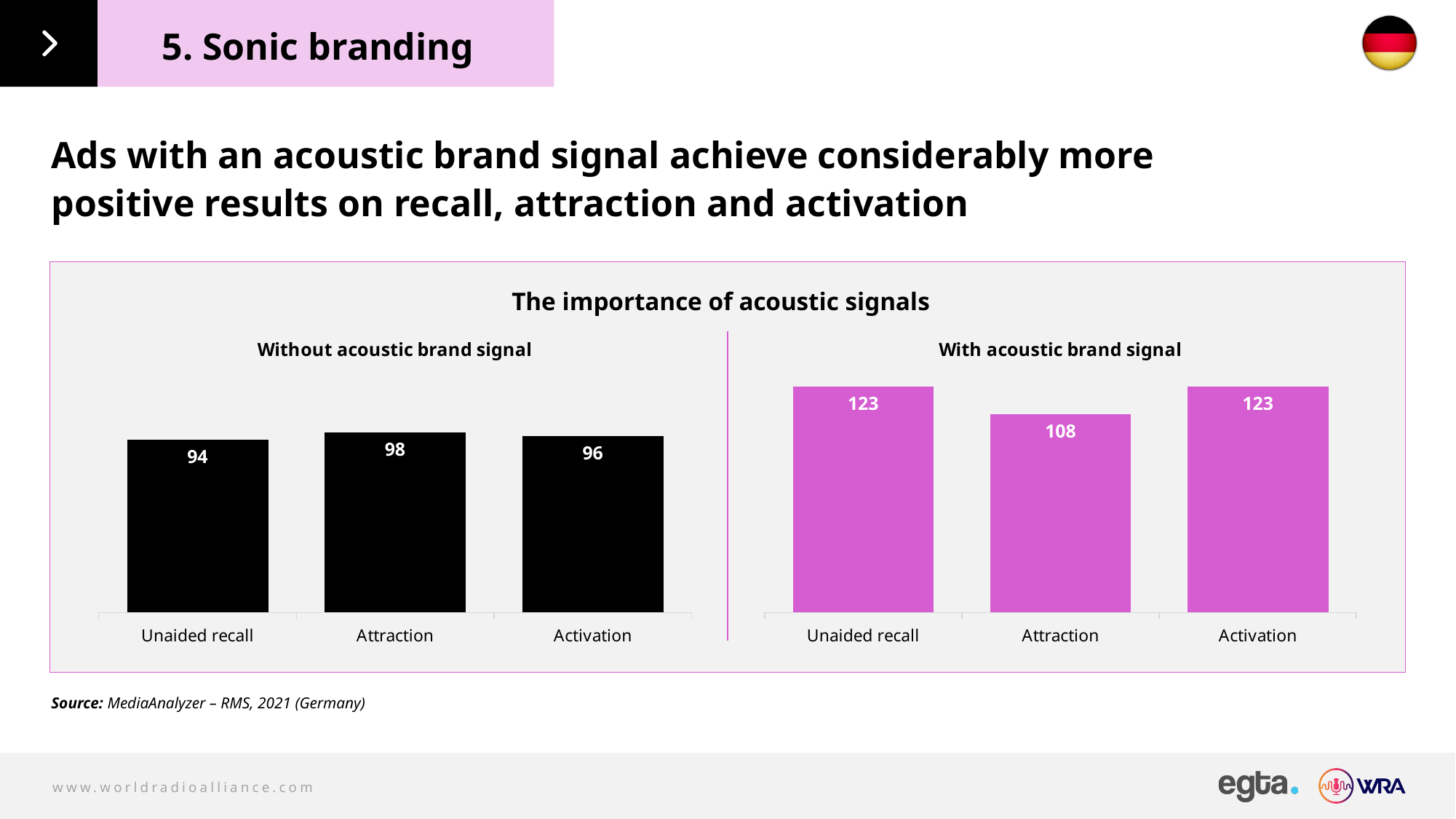
In the 'With acoustic brand signal' chart, what is the value for Attraction? 108 In the 'Without acoustic brand signal' chart, which category has the lowest value? Unaided recall How many categories are shown in the 'Without acoustic brand signal' chart? 3 In the 'Without acoustic brand signal' chart, what is the value for Unaided recall? 94 In the 'With acoustic brand signal' chart, what is the value for Activation? 123 Which is larger: Activation in the 'Without acoustic brand signal' chart or Attraction in the 'With acoustic brand signal' chart? Attraction in the 'With acoustic brand signal' chart In the 'Without acoustic brand signal' chart, which category has the highest value? Attraction In the 'With acoustic brand signal' chart, what is the difference between Activation and Attraction? 15 In the 'Without acoustic brand signal' chart, what is the value for Attraction? 98 What is the difference between the Unaided recall value in the 'With acoustic brand signal' chart and the Unaided recall value in the 'Without acoustic brand signal' chart? 29 What type of chart is used in the 'With acoustic brand signal' chart? Bar chart In the 'With acoustic brand signal' chart, which category has the lowest value? Attraction